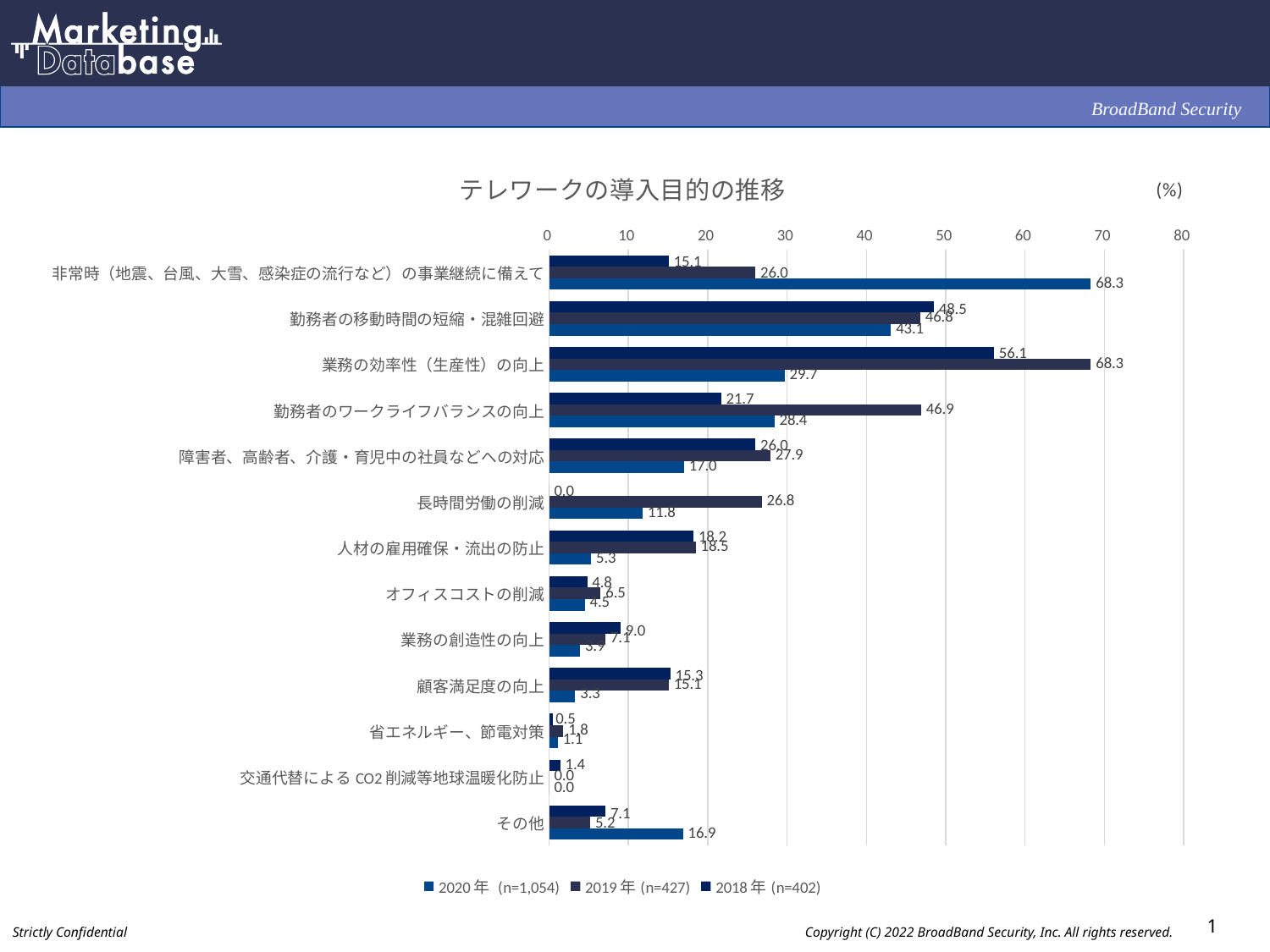
What is the 2019年 value for 長時間労働の削減? 26.8 What is the title of the chart? テレワークの導入目的の推移 What is the 2020年 value for 非常時（地震、台風、大雪、感染症の流行など）の事業継続に備えて? 68.3 How many series does the legend list? 3 For 非常時（地震、台風、大雪、感染症の流行など）の事業継続に備えて, what is the difference between the 2020年 value and the 2019年 value? 42.3 What kind of chart is shown on the slide? Horizontal bar chart How many categories are plotted on the y axis? 13 What is the 2020年 value for その他? 16.9 What is the 2020年 value for 業務の効率性（生産性）の向上? 29.7 Which category has the highest 2020年 value? 非常時（地震、台風、大雪、感染症の流行など）の事業継続に備えて For 勤務者のワークライフバランスの向上, which is larger: the 2019年 value or the 2020年 value? 2019年 What is the 2019年 value for 業務の効率性（生産性）の向上? 68.3